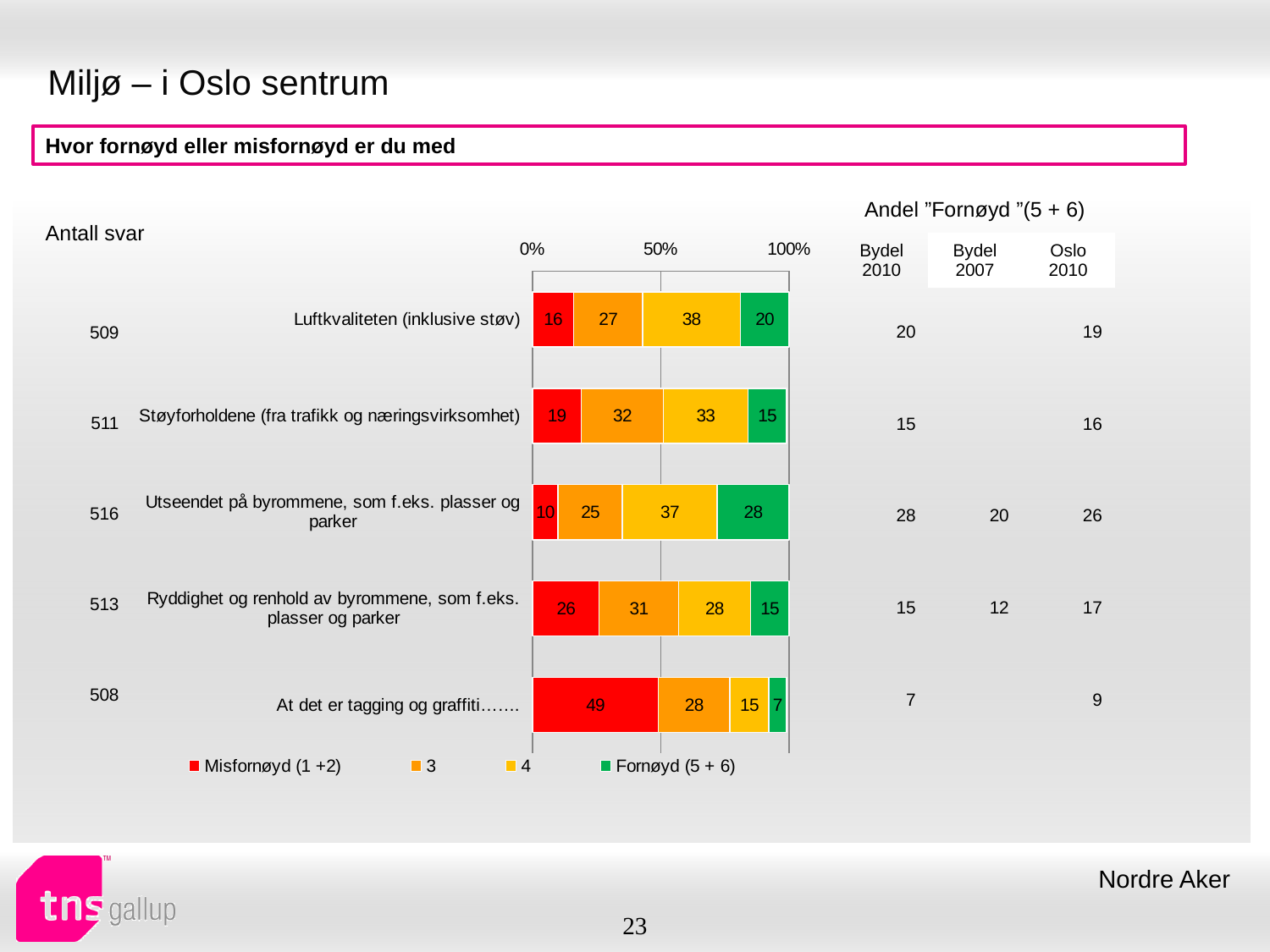
What is the value of "Fornøyd (5 + 6)" for "Luftkvaliteten (inklusive støv)"? 20 What colour represents the "Fornøyd (5 + 6)" series in the chart? green What is the difference between the "Misfornøyd (1 +2)" values for "At det er tagging og graffiti……." and "Luftkvaliteten (inklusive støv)"? 33 Which category has the highest "Fornøyd (5 + 6)" value? Utseendet på byrommene, som f.eks. plasser og parker Which is larger: the "Fornøyd (5 + 6)" value for "Luftkvaliteten (inklusive støv)" or for "Ryddighet og renhold av byrommene, som f.eks. plasser og parker"? Luftkvaliteten (inklusive støv) How many categories are plotted in the chart? 5 How many series does the legend list? 4 What is the value of "Misfornøyd (1 +2)" for "At det er tagging og graffiti……."? 49 What is the total of the stacked bar for "Ryddighet og renhold av byrommene, som f.eks. plasser og parker"? 100 What kind of chart is shown on the slide? stacked bar chart What is the value of series "3" for "Støyforholdene (fra trafikk og næringsvirksomhet)"? 32 Which category has the lowest "Misfornøyd (1 +2)" value? Utseendet på byrommene, som f.eks. plasser og parker